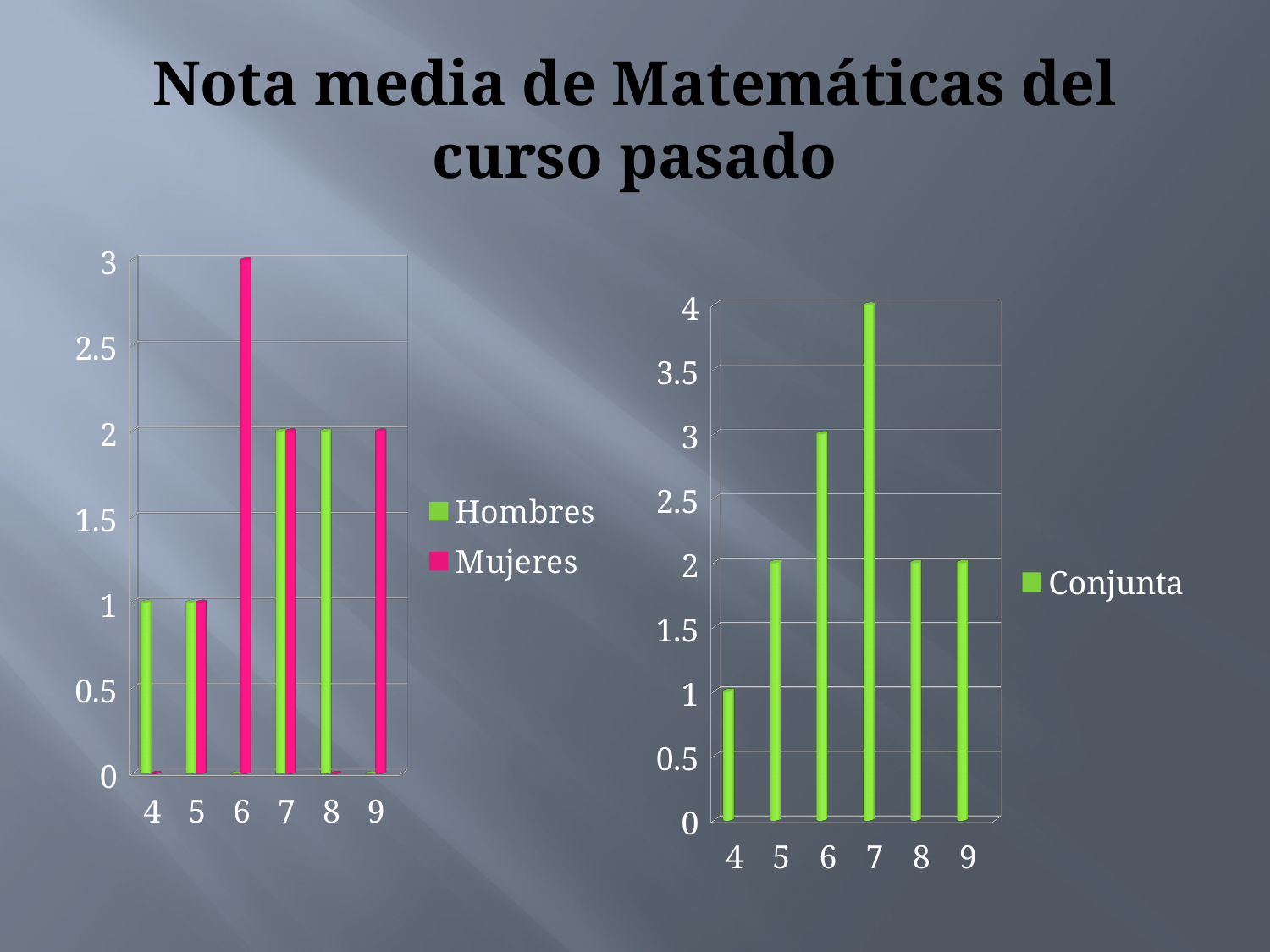
How many categories are shown on the x axis of the right chart? 6 In the right chart (Conjunta), what is the difference between the values for category 7 and category 4? 3 In the left chart, which category has the highest Mujeres value? 6 How many series does the legend of the left chart list? 2 In the left chart, what is the value for Hombres at category 7? 2 In the left chart, which is larger at category 6: Hombres or Mujeres? Mujeres In the right chart (Conjunta), which category has the lowest value? 4 In the left chart, what is the value for Mujeres at category 6? 3 What type of chart is the right chart? Bar chart In the right chart (Conjunta), is the value for category 6 greater or less than 2? greater In the right chart (Conjunta), which category has the highest value? 7 In the right chart (Conjunta), what is the value for category 7? 4